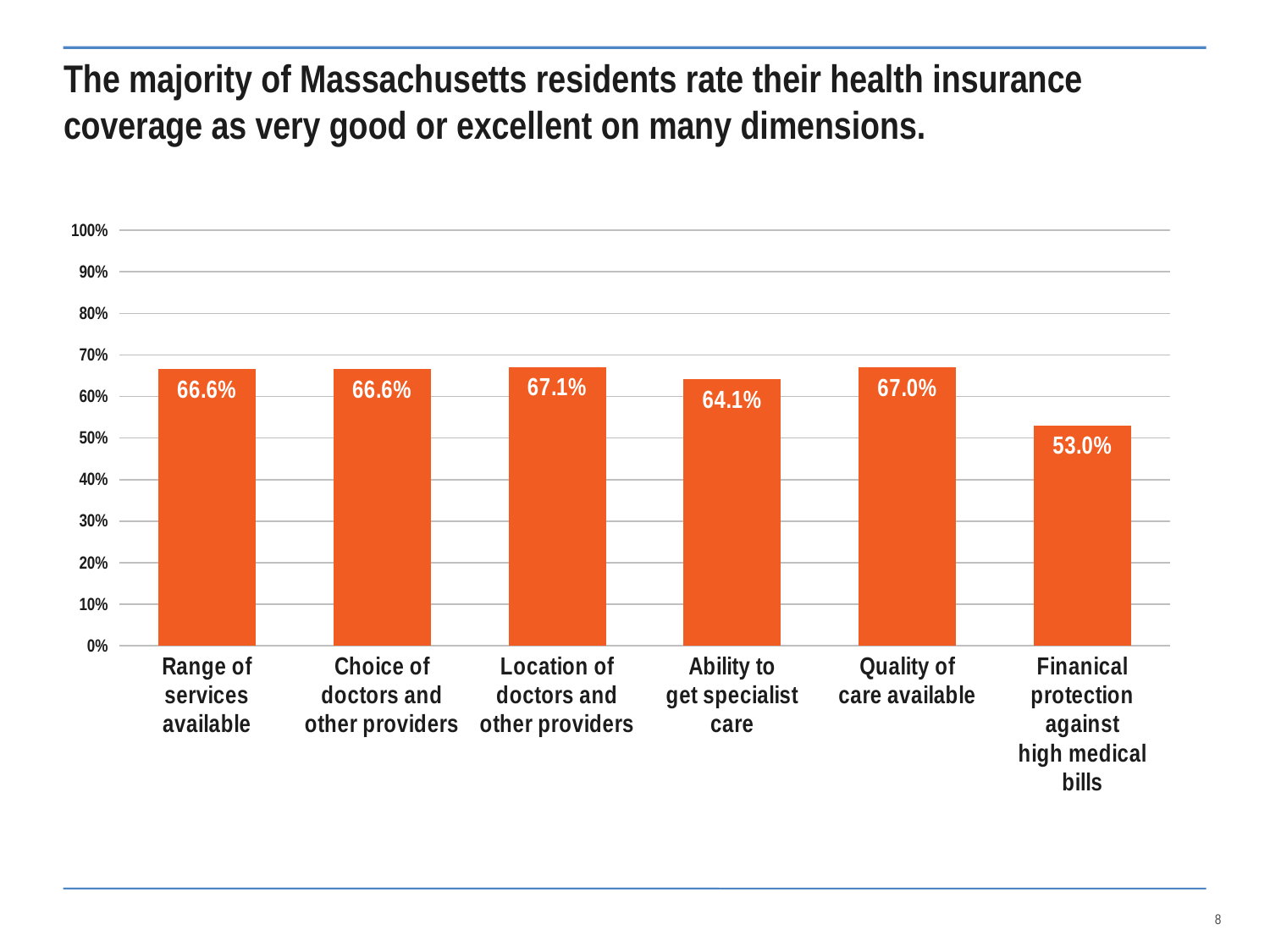
What percentage of Massachusetts residents rate the range of services available as very good or excellent? 66.6% Which category has the highest value in the chart? Location of doctors and other providers What is the value shown for 'Ability to get specialist care'? 64.1% What is the value shown for 'Finanical protection against high medical bills'? 53.0% What is the value shown for 'Quality of care available'? 67.0% Which is larger: the value for 'Choice of doctors and other providers' or the value for 'Ability to get specialist care'? Choice of doctors and other providers Which category has the lowest value in the chart? Finanical protection against high medical bills What kind of chart is shown on the slide? Bar chart Is the value for 'Finanical protection against high medical bills' greater or less than 60%? less What colour are the bars in the chart? Orange How many categories are shown in the chart? 6 What is the difference in percentage points between 'Location of doctors and other providers' and 'Finanical protection against high medical bills'? 14.1 percentage points